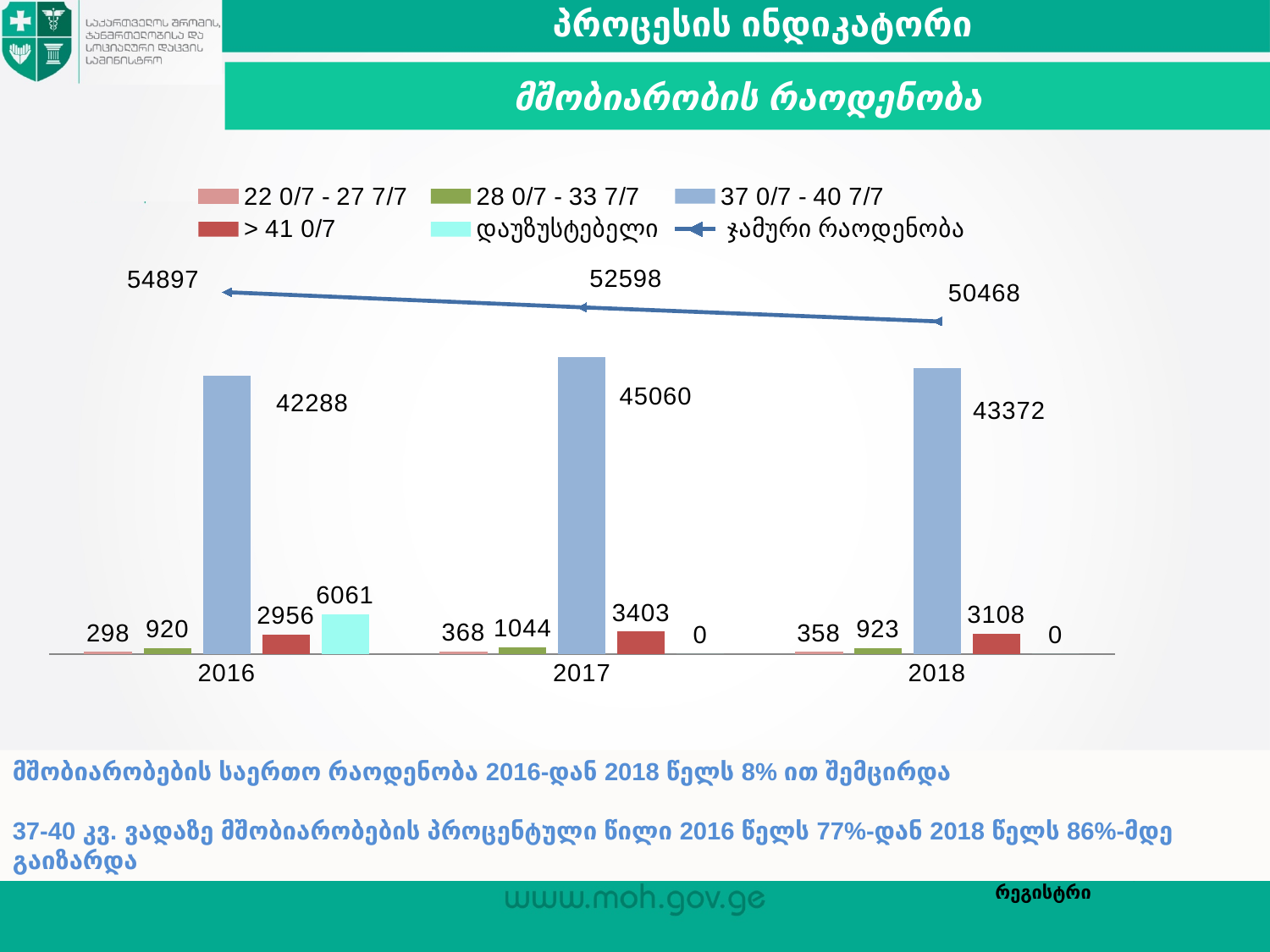
Does the total count (ჯამური რაოდენობა) rise or fall from 2016 to 2018? Fall What kind of chart is shown on the slide? Bar chart with a line What is the total count (ჯამური რაოდენობა) shown for 2018? 50468 How many years are shown on the x axis? 3 What is the difference between the total counts for 2016 and 2018? 4429 In which year is the "22 0/7 - 27 7/7" value lowest? 2016 What is the value for the "37 0/7 - 40 7/7" series in 2017? 45060 What is the value for the "დაუზუსტებელი" series in 2016? 6061 In which year is the total count (ჯამური რაოდენობა) highest? 2016 Which is larger: the "28 0/7 - 33 7/7" value in 2017 or in 2018? 2017 How many series does the legend list? 6 What is the value for the "> 41 0/7" series in 2016? 2956